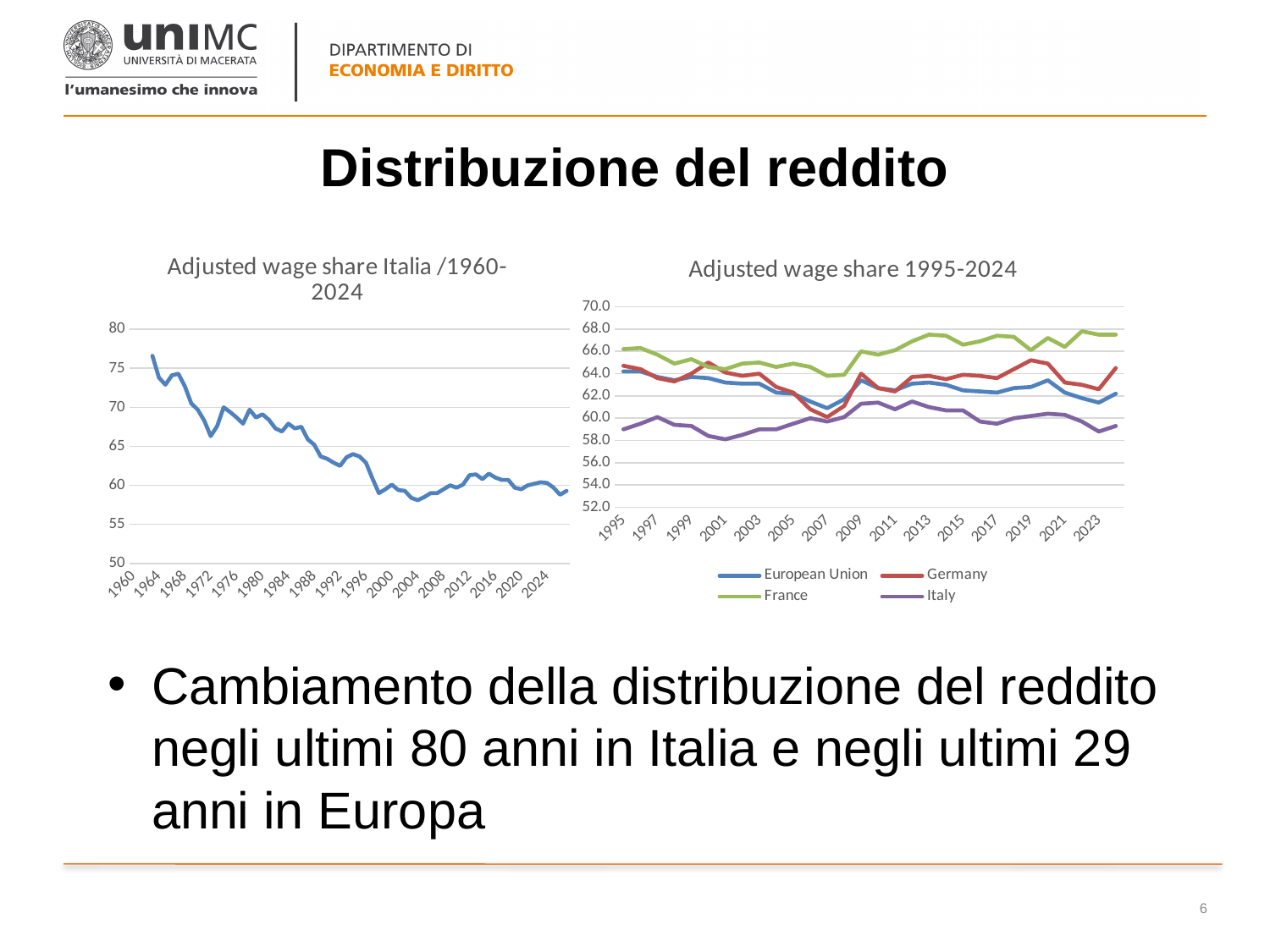
What kind of chart is the 'Adjusted wage share Italia /1960-2024' chart on the left? Line chart In the 'Adjusted wage share Italia /1960-2024' chart, is the value for 1972 greater or less than 70? less In the 'Adjusted wage share Italia /1960-2024' chart, do the values generally rise or fall from 1960 to 2024? Fall In the 'Adjusted wage share 1995-2024' chart, which is larger in 2010: France or Italy? France In the 'Adjusted wage share 1995-2024' chart, is the value for France in 2023 greater or less than 66.0? greater In the 'Adjusted wage share Italia /1960-2024' chart, is the value for 2004 greater or less than 60? less Which series in the 'Adjusted wage share 1995-2024' chart is drawn in red? Germany In the 'Adjusted wage share 1995-2024' chart, which series has the lowest values across the period? Italy In the 'Adjusted wage share 1995-2024' chart, which series has the highest values across the period? France How many series does the legend of the 'Adjusted wage share 1995-2024' chart list? 4